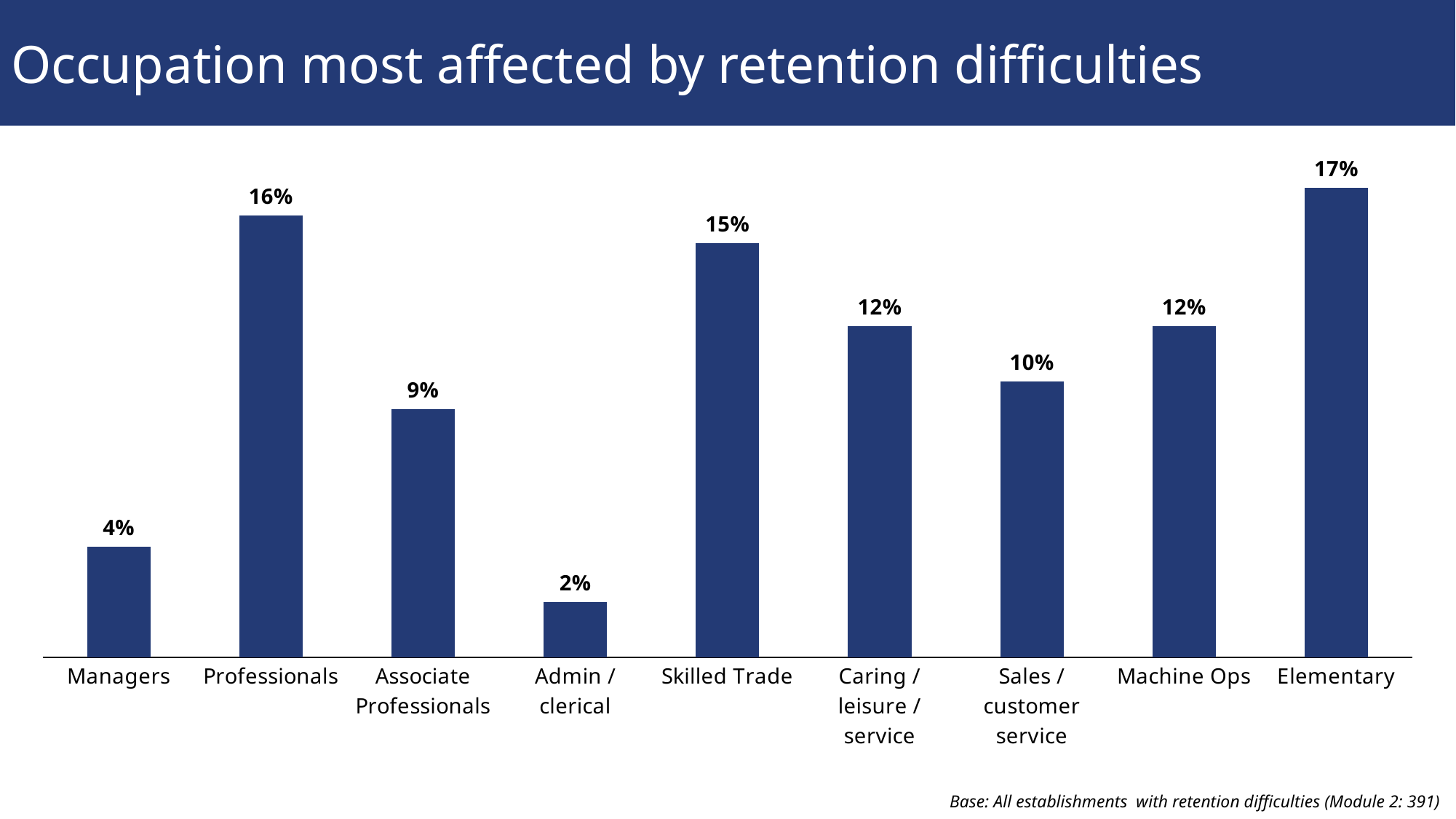
Which occupation has the lowest value? Admin / clerical What is the value for Sales / customer service? 10% What is the title of the chart? Occupation most affected by retention difficulties Which is larger, the value for Skilled Trade or the value for Caring / leisure / service? Skilled Trade How many occupation categories are shown in the chart? 9 Which is larger, the value for Machine Ops or the value for Sales / customer service? Machine Ops What is the value for Skilled Trade? 15% Which occupation has the highest value? Elementary What is the value for Managers? 4% What kind of chart is shown on the slide? Bar chart What is the difference between the values for Professionals and Associate Professionals? 7% What is the difference between the values for Elementary and Managers? 13%